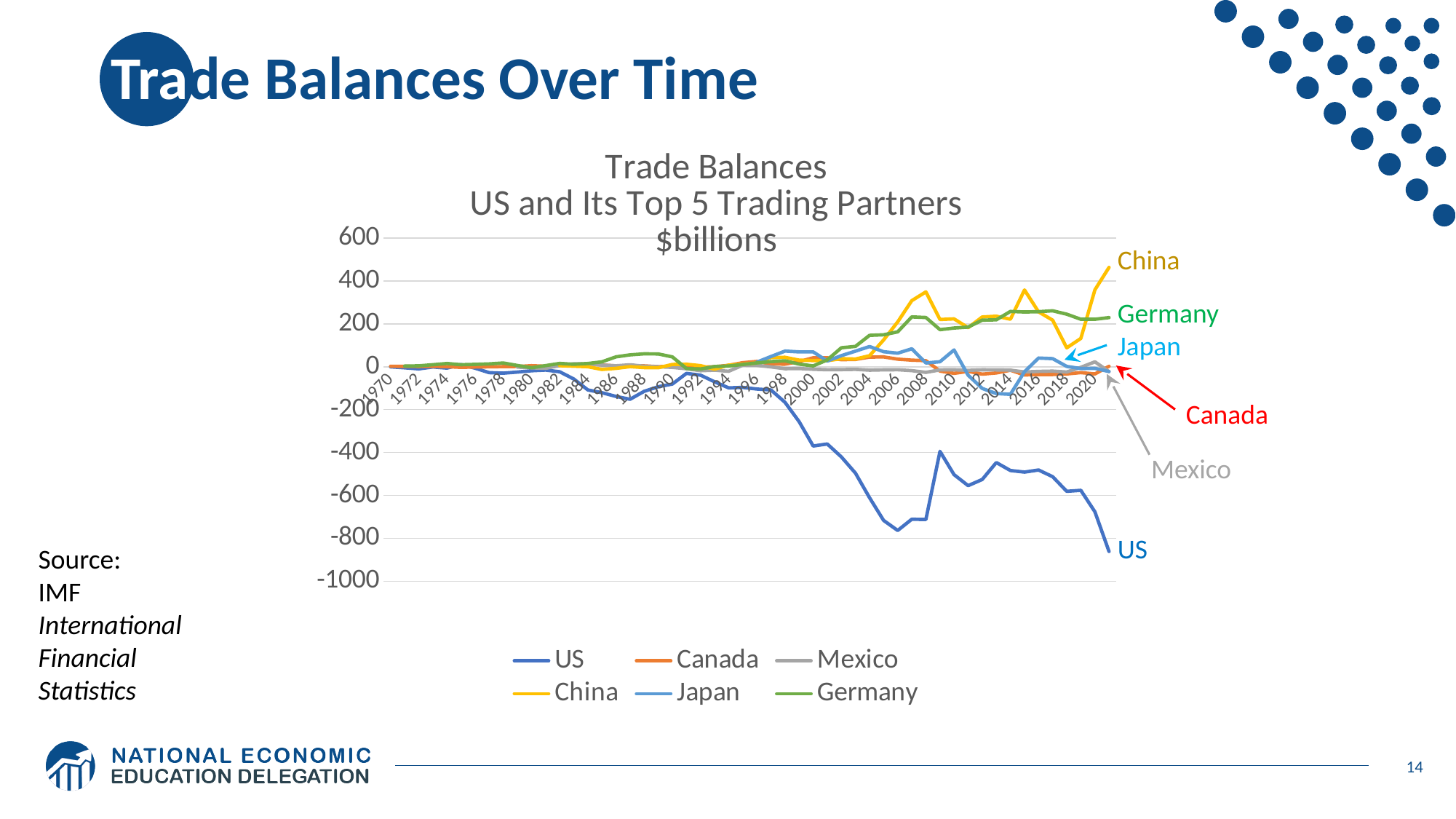
What kind of chart is shown on the slide? Line chart Is the value for China in 2020 greater or less than 400? less Is the value for Germany in 2020 greater or less than 200? greater Which series has the lowest value in 2020? US Is the value for the US in 2020 greater or less than -800? greater What unit is stated in the chart title? $billions How many series does the legend list? 6 Does the US line generally rise or fall from 1970 to 2020? Fall Which series has the highest value in 2020? China In 2020, which is larger, the value for China or the value for Germany? China What is the source of the data shown in the chart? IMF International Financial Statistics